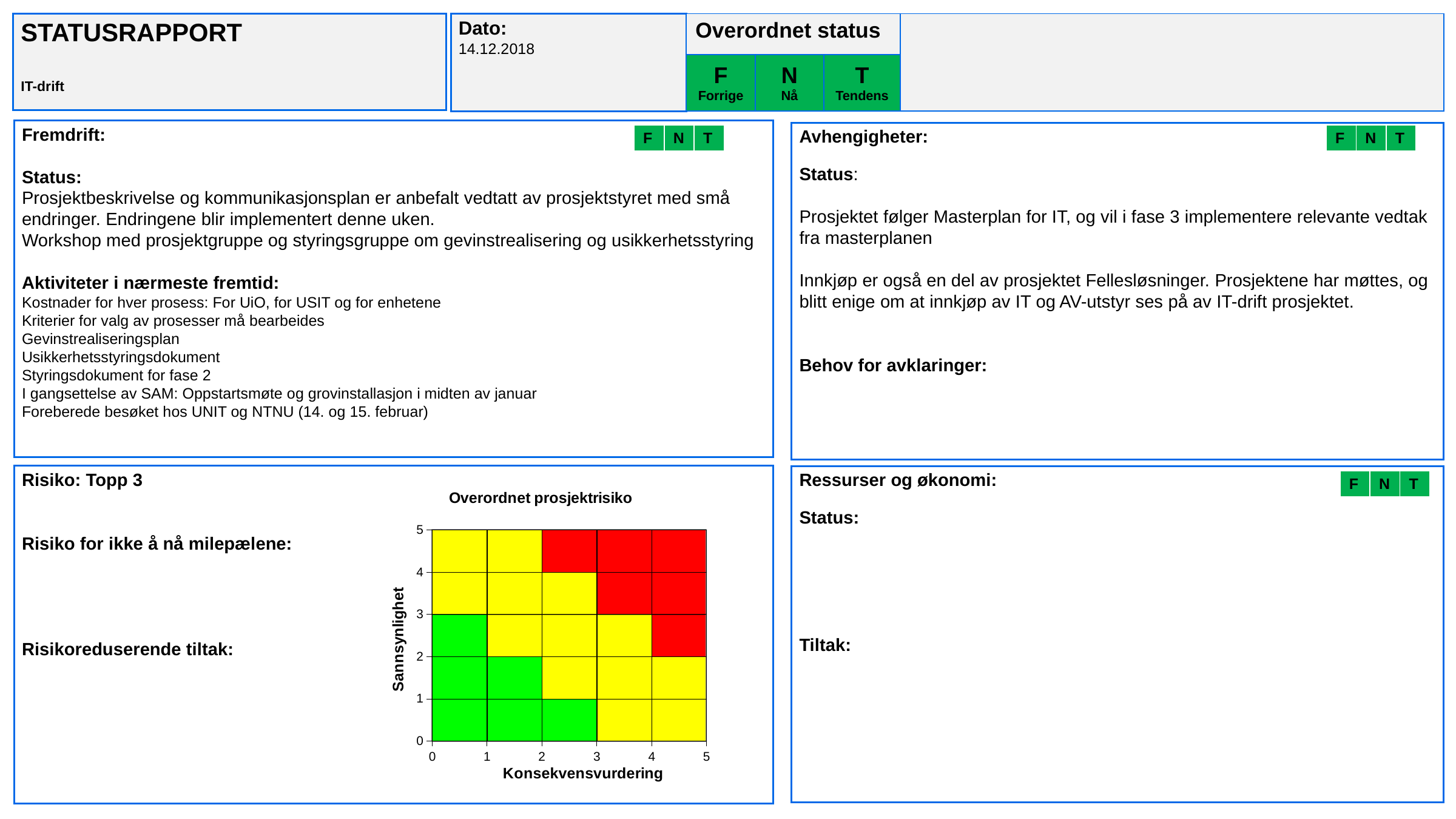
How many distinct colours are used in the cells of the Overordnet prosjektrisiko matrix? 3 What is the label of the x axis of the Overordnet prosjektrisiko chart? Konsekvensvurdering What is the highest value shown on the y axis (Sannsynlighet) of the Overordnet prosjektrisiko chart? 5 In the Overordnet prosjektrisiko chart, what colour is the cell at the bottom left corner (Konsekvensvurdering 0–1, Sannsynlighet 0–1)? green How many cells in total does the Overordnet prosjektrisiko matrix have? 25 In the Overordnet prosjektrisiko chart, what colour is the cell at Konsekvensvurdering 2–3 and Sannsynlighet 2–3? yellow What is the lowest value shown on the x axis of the Overordnet prosjektrisiko chart? 0 What kind of chart is Overordnet prosjektrisiko? risk matrix (heat map) How many red cells are there in the Overordnet prosjektrisiko matrix? 6 In the Overordnet prosjektrisiko chart, what colour is the cell at the top right corner (Konsekvensvurdering 4–5, Sannsynlighet 4–5)? red What is the title of the chart in the Risiko: Topp 3 section? Overordnet prosjektrisiko